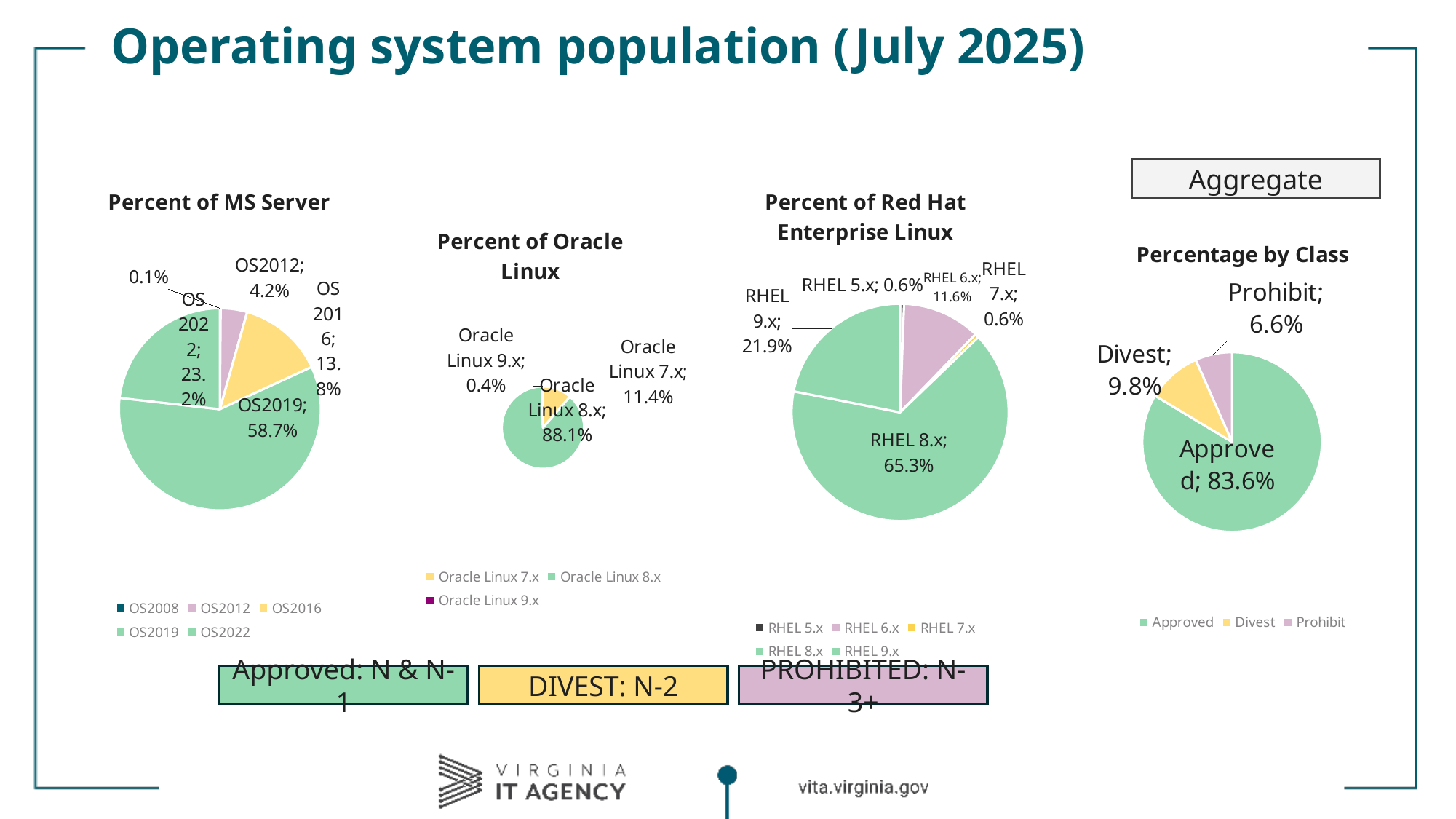
In the 'Percentage by Class' chart, what share is Divest? 9.8% What kind of chart is the 'Percentage by Class' chart? Pie chart In the 'Percent of Red Hat Enterprise Linux' chart, which is larger, RHEL 6.x or RHEL 9.x? RHEL 9.x In the 'Percent of MS Server' chart, what share does OS2019 have? 58.7% In the 'Percent of MS Server' chart, what is the difference between the OS2022 and OS2016 shares? 9.4% In the 'Percent of Oracle Linux' chart, what share does Oracle Linux 7.x have? 11.4% In the 'Percent of Oracle Linux' chart, which version has the smallest share? Oracle Linux 9.x How many series does the legend of the 'Percent of Red Hat Enterprise Linux' chart list? 5 In the 'Percentage by Class' chart, what is the difference between the Approved and Prohibit shares? 77.0% In the 'Percent of MS Server' chart, which operating system has the largest share? OS2019 In the 'Percent of Red Hat Enterprise Linux' chart, what share does RHEL 9.x have? 21.9% How many series does the legend of the 'Percent of Oracle Linux' chart list? 3